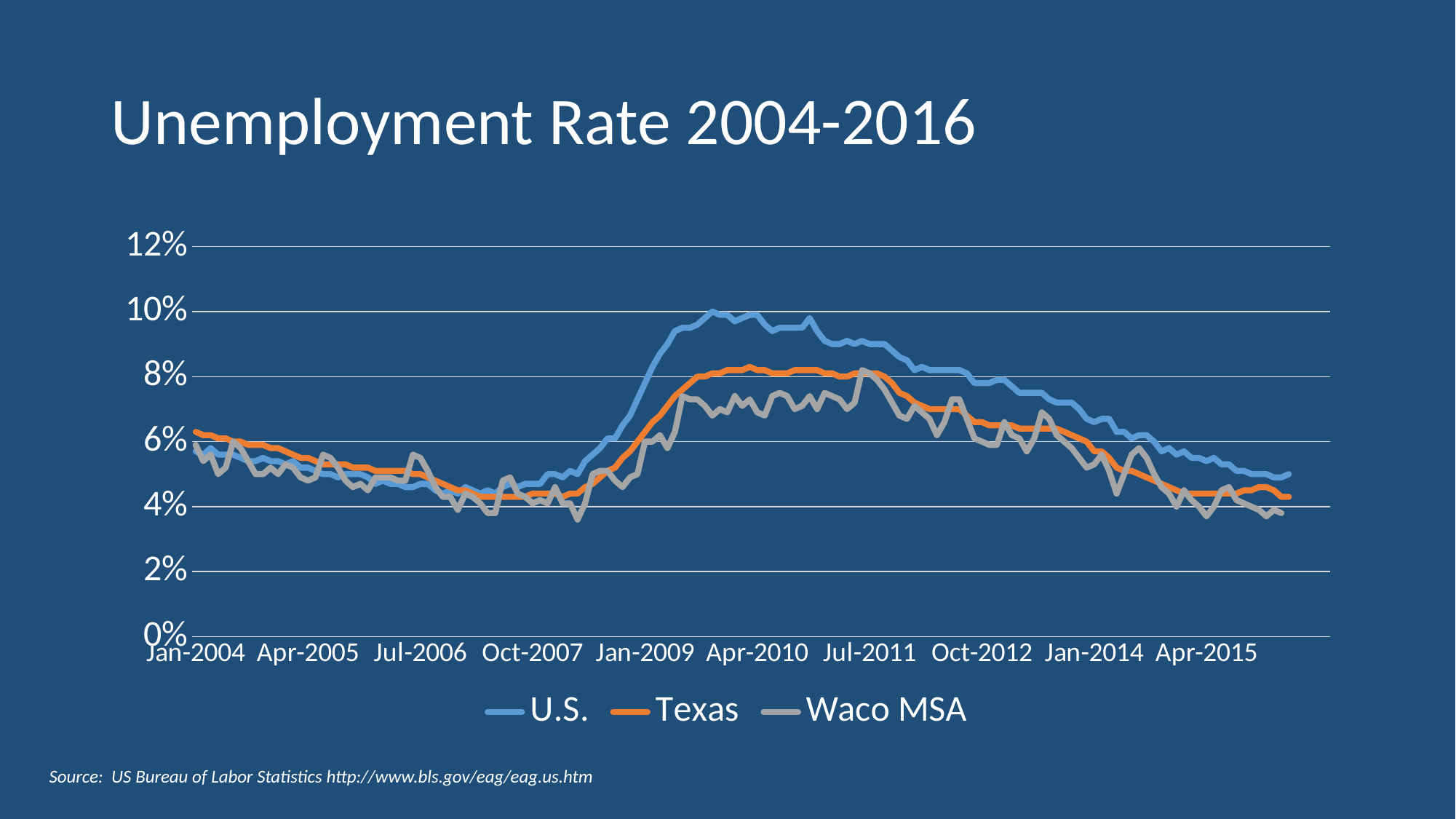
Is the U.S. unemployment rate at Apr-2010 greater or less than 8%? greater Is the Texas unemployment rate at Apr-2010 greater or less than 6%? greater Is the Waco MSA unemployment rate at Oct-2007 greater or less than 6%? less Which series is drawn in orange? Texas At Apr-2010, which series has the higher unemployment rate, U.S. or Texas? U.S. Does the U.S. unemployment rate rise or fall between Oct-2007 and Jan-2009? rise How many series does the legend list? 3 What kind of chart is shown on the slide? line chart Which series reaches the highest peak on the chart? U.S. Does the U.S. unemployment rate rise or fall between Apr-2010 and Apr-2015? fall What is the title of the chart? Unemployment Rate 2004-2016